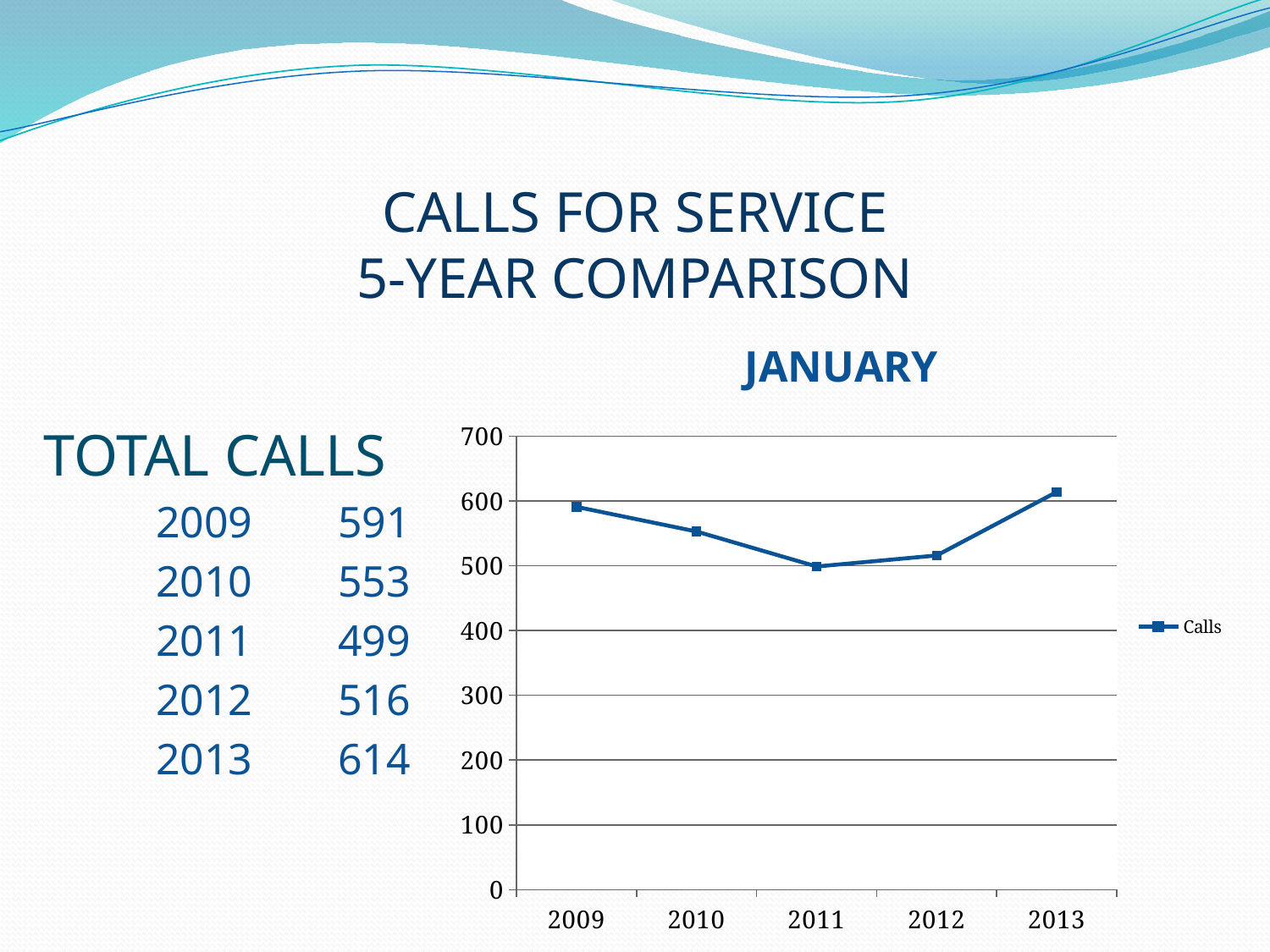
Which year has more calls, 2009 or 2010? 2009 Which year has the lowest number of calls? 2011 How many series does the chart legend list? 1 Is the value for 2012 greater or less than 600? less What is the number of calls for 2013? 614 Which year has the highest number of calls? 2013 What type of chart is shown on the slide? line chart What is the number of calls for 2011? 499 How many years are plotted on the x axis of the chart? 5 What is the title of the chart? JANUARY What is the name of the series in the chart legend? Calls What is the difference in calls between 2013 and 2011? 115